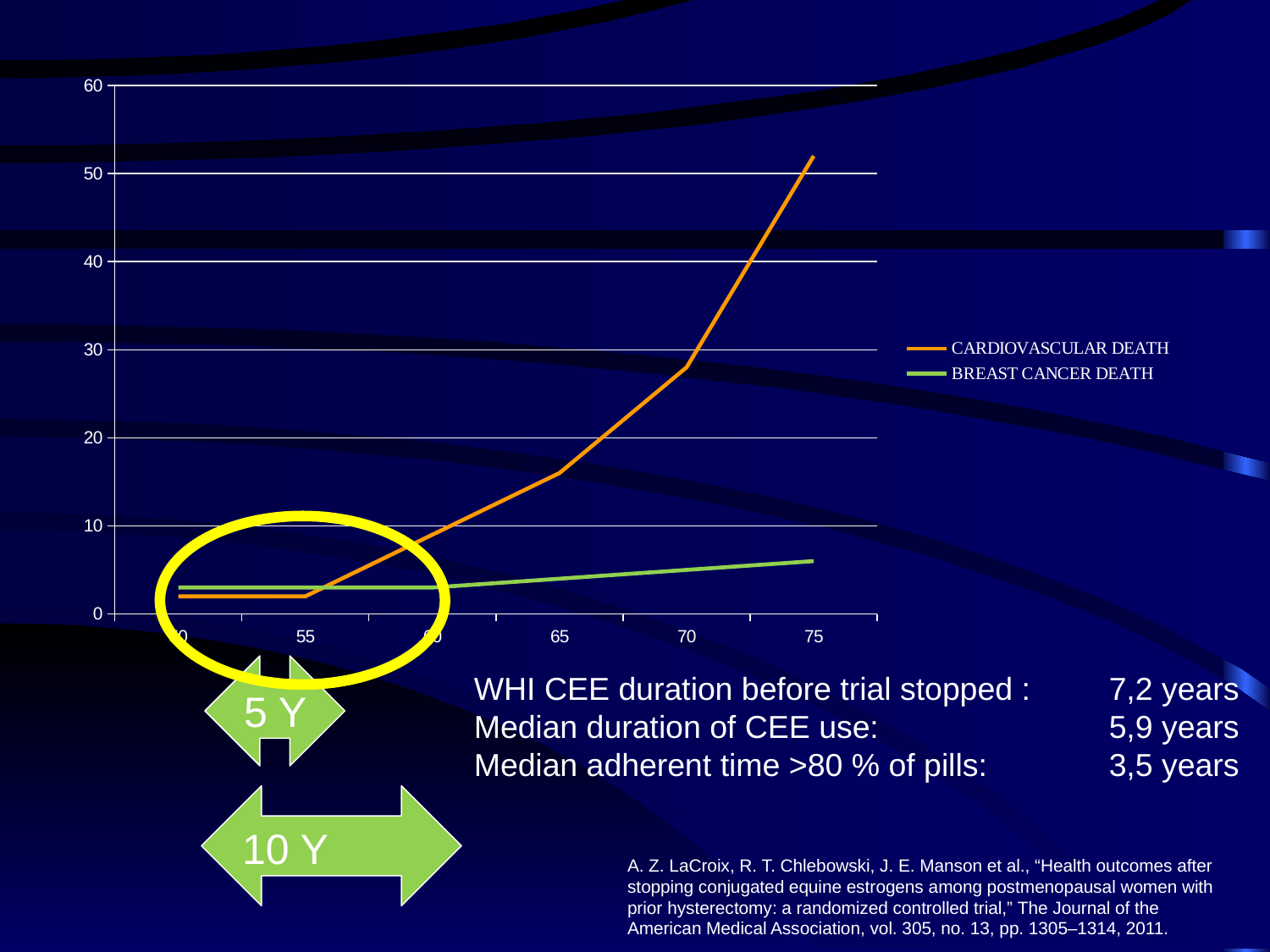
Does the CARDIOVASCULAR DEATH line rise or fall from 55 to 75 along the x axis? rise Is the CARDIOVASCULAR DEATH value at 65 greater or less than 10? greater Which series is drawn in orange in the chart? CARDIOVASCULAR DEATH What kind of chart is shown on the slide? line chart At 75, which series has the larger value, CARDIOVASCULAR DEATH or BREAST CANCER DEATH? CARDIOVASCULAR DEATH Is the CARDIOVASCULAR DEATH value at 55 greater or less than 10? less Is the CARDIOVASCULAR DEATH value at 70 greater or less than 30? less How many series does the chart's legend list? 2 What is the highest value shown on the chart's vertical axis? 60 At 70, which series has the larger value, CARDIOVASCULAR DEATH or BREAST CANCER DEATH? CARDIOVASCULAR DEATH